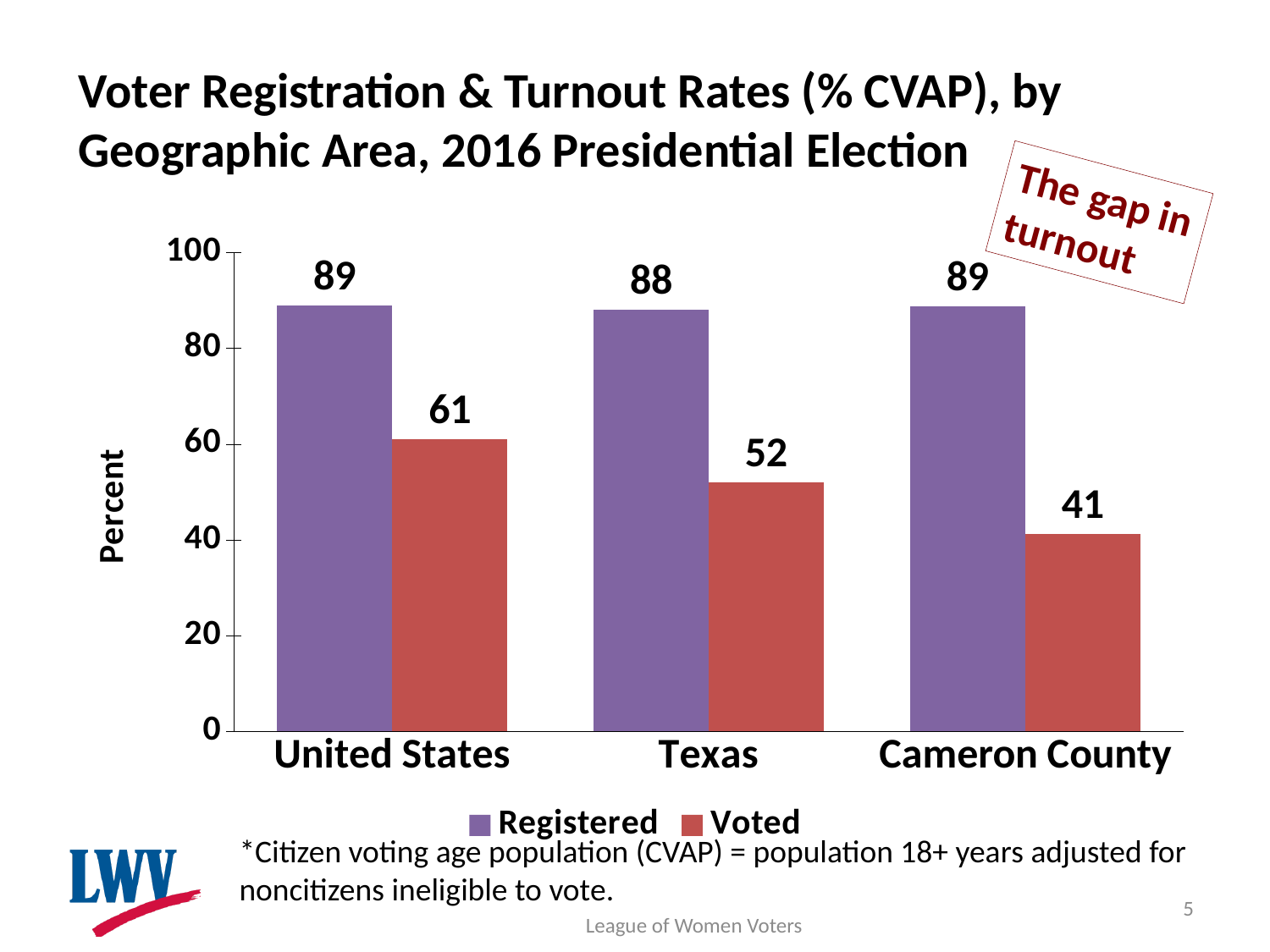
Which geographic area has the lowest Voted value? Cameron County What is the Voted value for United States? 61 How many geographic areas are shown on the x axis? 3 What is the label on the vertical axis? Percent How many series does the legend list? 2 What is the Registered value for Cameron County? 89 Which is larger, the Voted value for Texas or the Voted value for Cameron County? Texas What kind of chart is shown on the slide? Bar chart What is the Voted value for Texas? 52 Which geographic area has the highest Voted value? United States What is the difference between the Registered and Voted values for Cameron County? 48 What is the difference between the Voted values for United States and Texas? 9